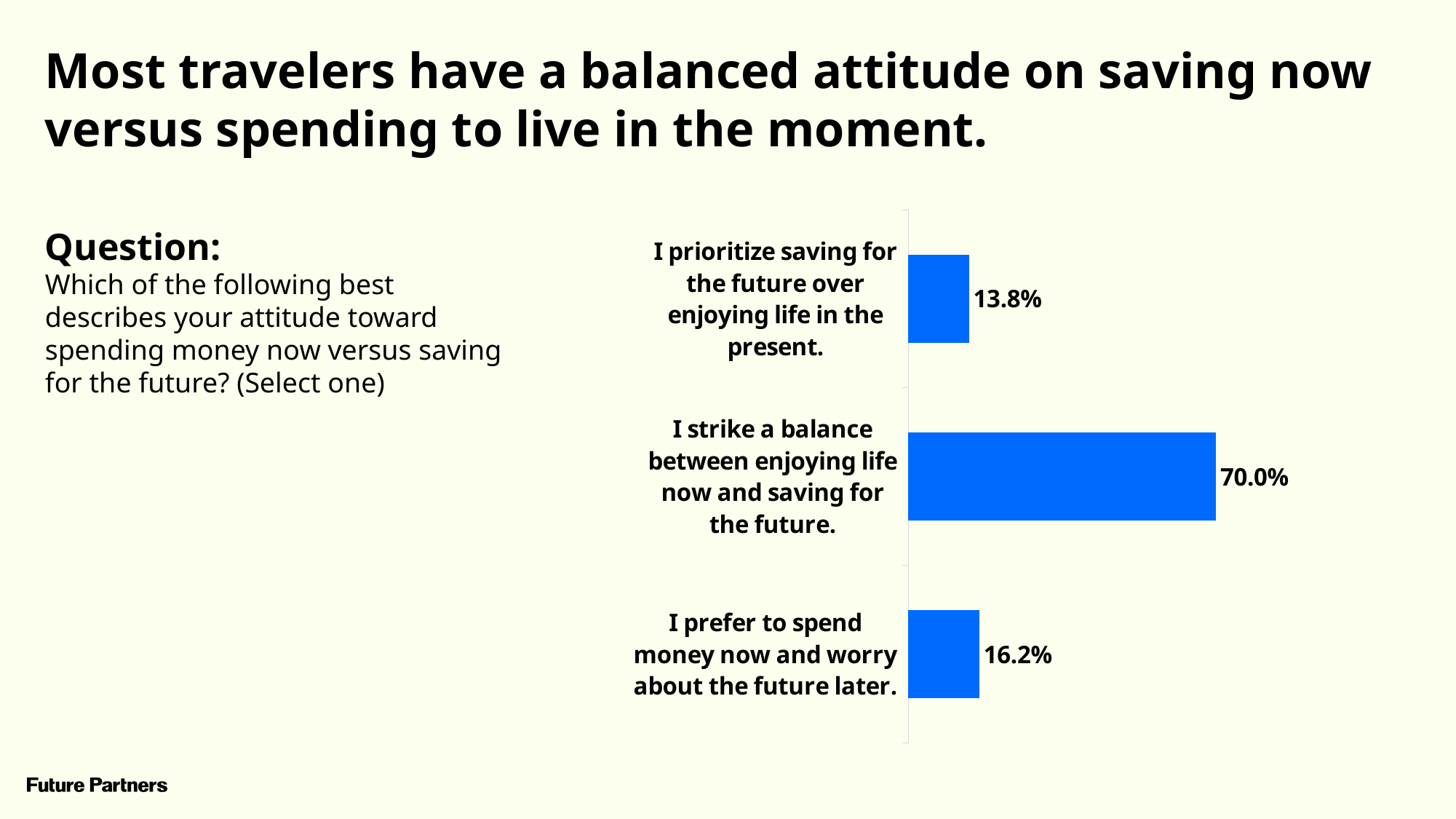
Which attitude has the highest share of travelers? I strike a balance between enjoying life now and saving for the future. What is the total of the three percentages shown in the chart? 100.0% Which attitude has the lowest share of travelers? I prioritize saving for the future over enjoying life in the present. What percentage of travelers say they prioritize saving for the future over enjoying life in the present? 13.8% How many attitude categories are shown in the chart? 3 What percentage of travelers say they prefer to spend money now and worry about the future later? 16.2% What colour are the bars in the chart? Blue What is the difference in percentage points between those who strike a balance and those who prefer to spend money now? 53.8 What is the difference in percentage points between those who prefer to spend money now and those who prioritize saving for the future? 2.4 Which is larger: the share who prefer to spend money now or the share who prioritize saving for the future? I prefer to spend money now and worry about the future later. What type of chart is shown on the slide? Bar chart What percentage of travelers say they strike a balance between enjoying life now and saving for the future? 70.0%